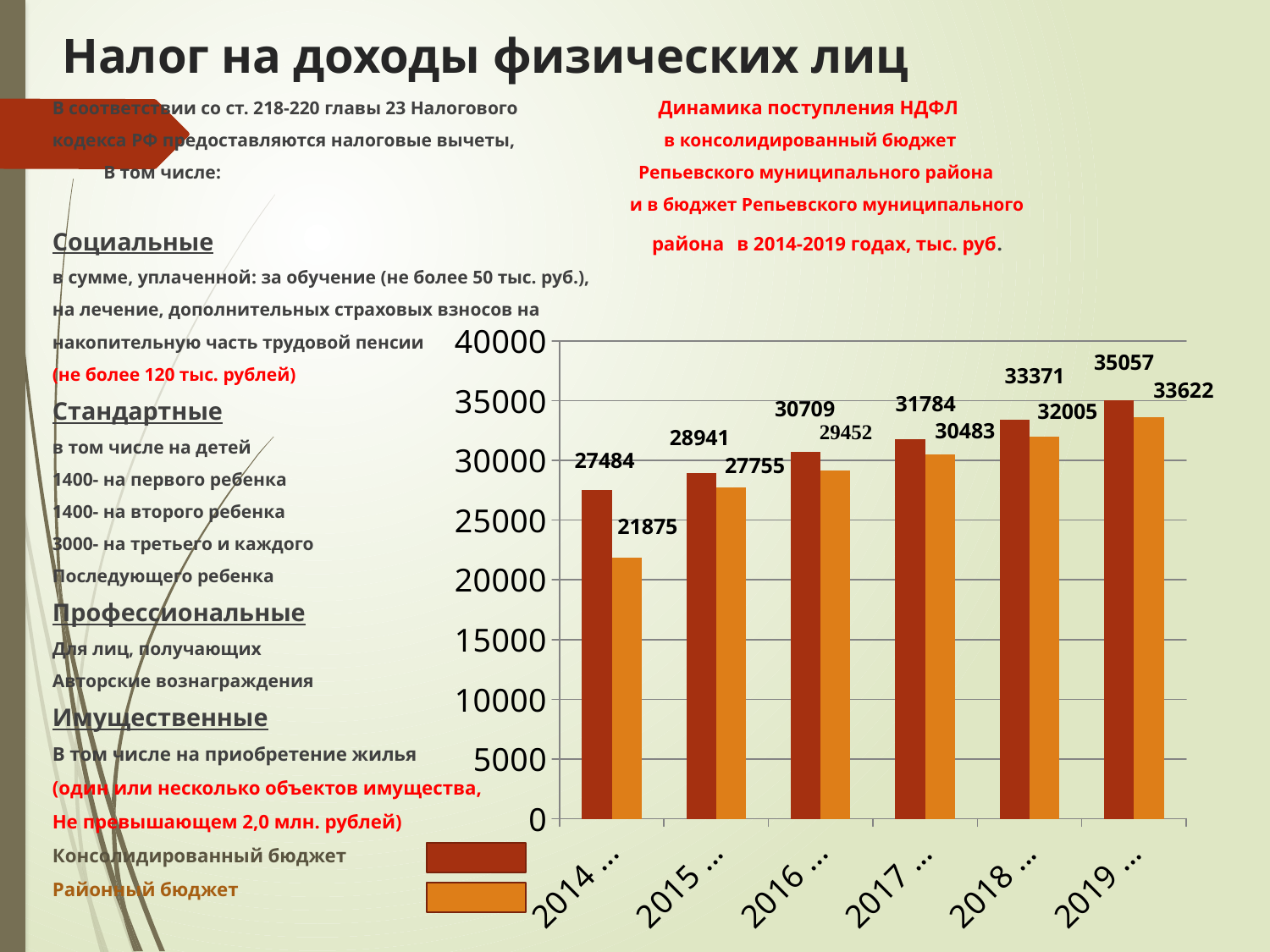
What is the value for the consolidated budget (Консолидированный бюджет) in 2014? 27484 What kind of chart is shown on the slide? bar chart What is the difference between the consolidated budget and the district budget values in 2014? 5609 Do the consolidated budget (Консолидированный бюджет) values rise or fall from 2014 to 2019? rise In which year is the consolidated budget (Консолидированный бюджет) value the highest? 2019 What is the value for the district budget (Районный бюджет) in 2017? 30483 What is the value for the district budget (Районный бюджет) in 2014? 21875 In which year is the district budget (Районный бюджет) value the lowest? 2014 How many series does the chart's legend list? 2 How many years are shown on the x axis of the chart? 6 What is the value for the consolidated budget (Консолидированный бюджет) in 2019? 35057 Which is larger in 2018: the consolidated budget value or the district budget value? Консолидированный бюджет (33371)